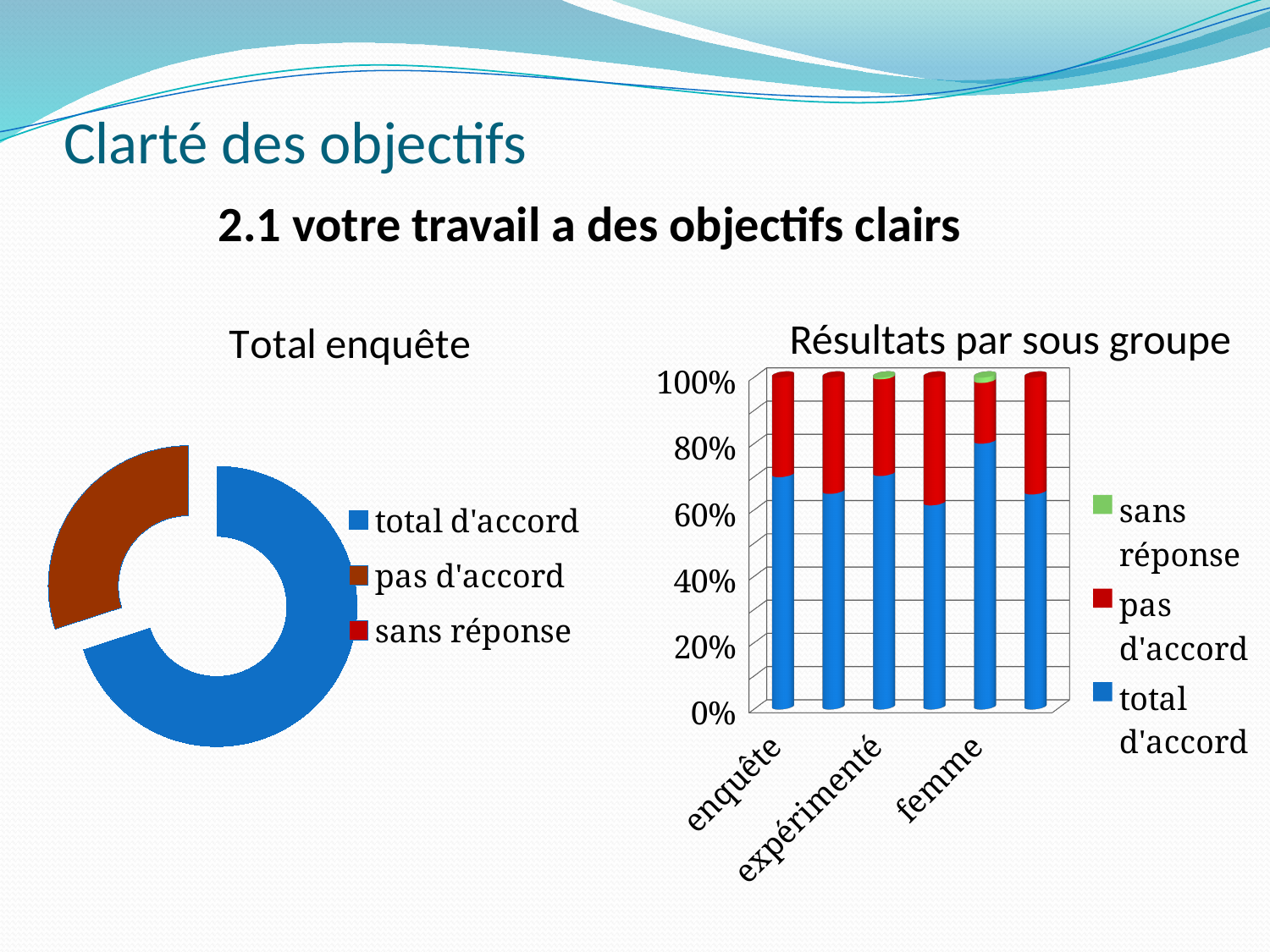
In the 'Résultats par sous groupe' chart, is the 'total d'accord' value for 'enquête' greater or less than 60%? greater In the 'Résultats par sous groupe' chart, how many bars are plotted? 6 What kind of chart is the 'Résultats par sous groupe' chart on the right? stacked bar chart In the 'Total enquête' chart, how many series does the legend list? 3 In the 'Résultats par sous groupe' chart, what is the highest value shown on the vertical axis? 100% In the 'Total enquête' chart, which category has the largest share? total d'accord In the 'Résultats par sous groupe' chart, is the 'total d'accord' value for 'femme' greater or less than 60%? greater What kind of chart is the 'Total enquête' chart on the left? doughnut chart In the 'Résultats par sous groupe' chart, how many series does the legend list? 3 In the 'Résultats par sous groupe' chart, is the 'total d'accord' value for 'expérimenté' greater or less than 40%? greater In the 'Total enquête' chart, which colour represents 'pas d'accord'? brown In the 'Résultats par sous groupe' chart, which has the larger 'total d'accord' value, 'femme' or 'enquête'? femme